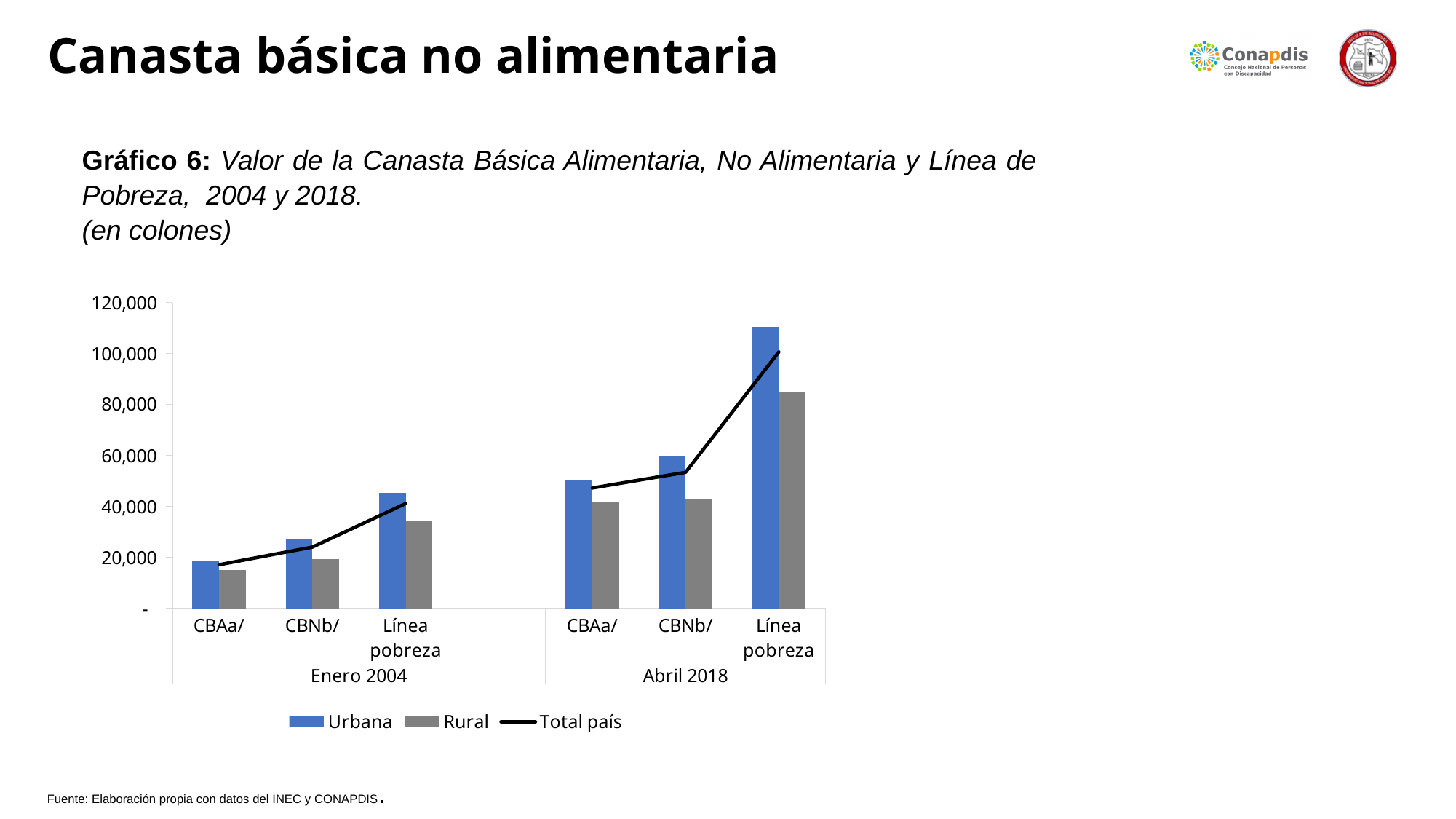
For Línea pobreza in Abril 2018, which is larger, the Urbana value or the Rural value? Urbana How many series does the legend list? 3 Which category has the lowest Rural bar? CBAa/, Enero 2004 Is the Urbana value for CBAa/ in Abril 2018 greater or less than 40,000? greater Is the Urbana value for Línea pobreza in Abril 2018 greater or less than 100,000? greater How many categories are shown on the x axis across both periods? 6 What colour are the Urbana bars? Blue What kind of chart is used to show the Urbana and Rural series? Bar chart Which category has the highest Urbana bar? Línea pobreza, Abril 2018 Which series is drawn as a line rather than bars? Total país Is the Rural value for Línea pobreza in Enero 2004 greater or less than 40,000? less Does the Total país line rise or fall from left to right across the chart? Rises